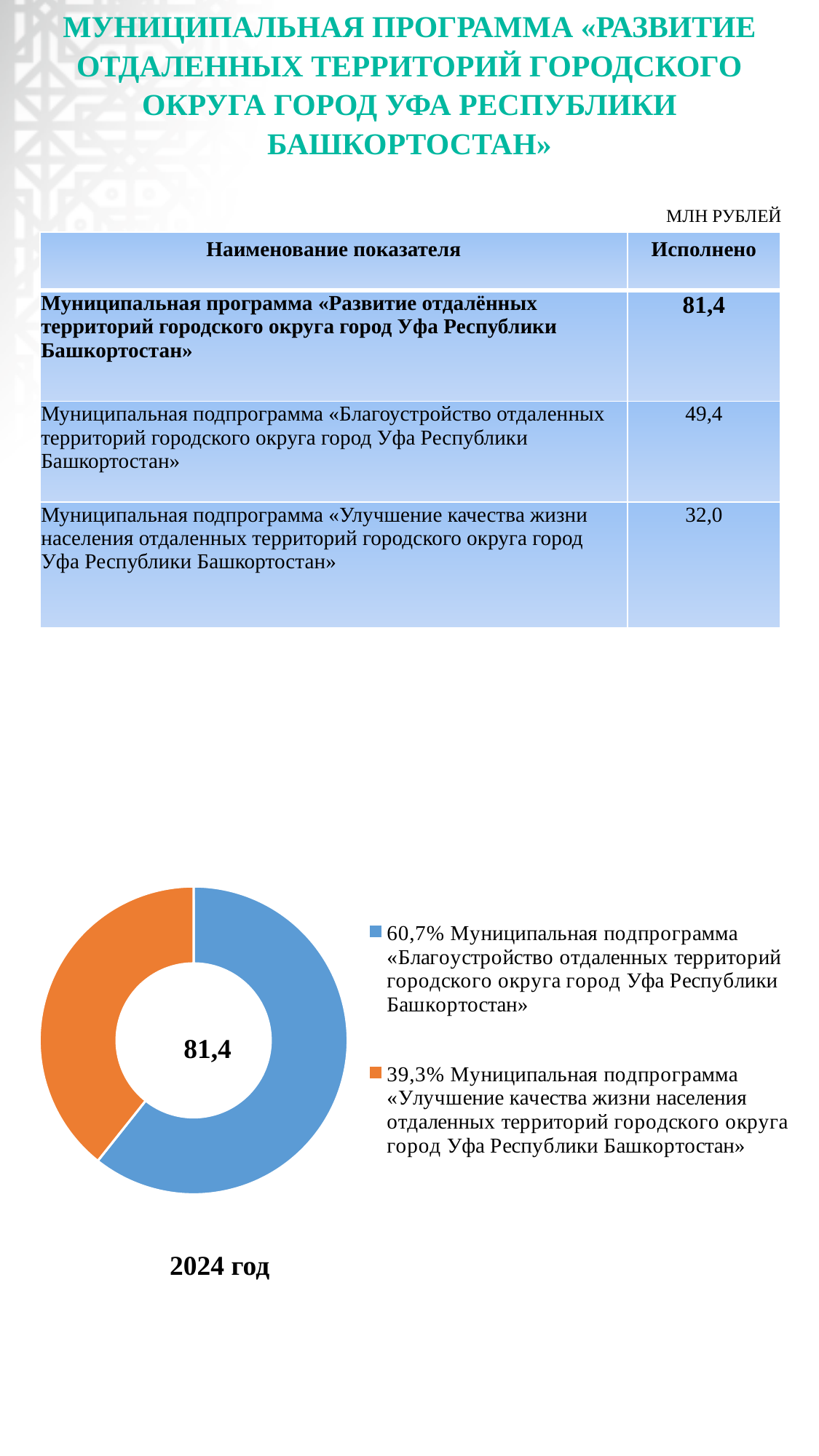
What colour is the slice for the subprogramme «Улучшение качества жизни населения отдаленных территорий» in the doughnut chart? Orange Which subprogramme has the largest slice in the doughnut chart? Муниципальная подпрограмма «Благоустройство отдаленных территорий городского округа город Уфа Республики Башкортостан» What kind of chart is shown on the slide? Doughnut (pie) chart How many entries does the legend of the doughnut chart list? 2 What share of the doughnut chart does the subprogramme «Благоустройство отдаленных территорий городского округа город Уфа Республики Башкортостан» take? 60,7% Is the share of the subprogramme «Благоустройство отдаленных территорий» in the doughnut chart greater or less than 50%? greater What is the difference in percentage points between the two slices of the doughnut chart? 21,4 What share of the doughnut chart does the subprogramme «Улучшение качества жизни населения отдаленных территорий городского округа город Уфа Республики Башкортостан» take? 39,3% How many slices does the doughnut chart have? 2 What value is printed in the centre of the doughnut chart? 81,4 Which slice is larger in the doughnut chart: «Благоустройство отдаленных территорий» or «Улучшение качества жизни населения»? «Благоустройство отдаленных территорий» Which subprogramme has the smallest slice in the doughnut chart? Муниципальная подпрограмма «Улучшение качества жизни населения отдаленных территорий городского округа город Уфа Республики Башкортостан»